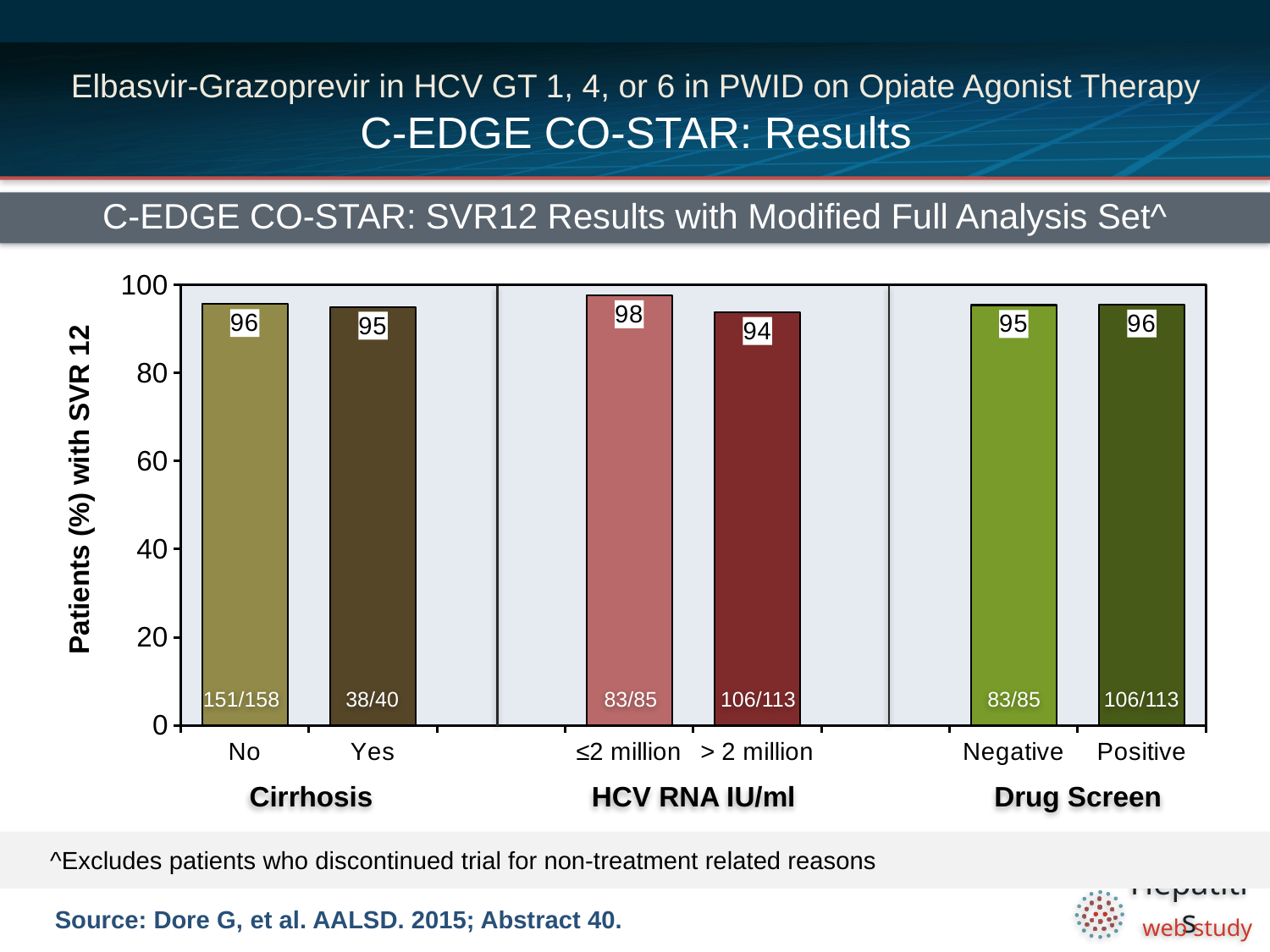
How many bars are plotted in the chart? 6 What is the SVR12 rate (%) for patients with cirrhosis (Yes)? 95 What type of chart is shown on the slide? Bar chart Which has a higher SVR12 rate: Drug Screen Negative or Drug Screen Positive? Drug Screen Positive What fraction of patients is shown for the Cirrhosis No bar? 151/158 What is the difference in SVR12 rate between the HCV RNA ≤2 million and > 2 million groups? 4 What fraction of patients is shown for the Drug Screen Positive bar? 106/113 What is the SVR12 rate (%) for patients with HCV RNA > 2 million IU/ml? 94 What is the SVR12 rate (%) for patients with no cirrhosis? 96 Which subgroup has the lowest SVR12 rate? HCV RNA > 2 million What is the SVR12 rate (%) for patients with HCV RNA ≤2 million IU/ml? 98 Which subgroup has the highest SVR12 rate? HCV RNA ≤2 million